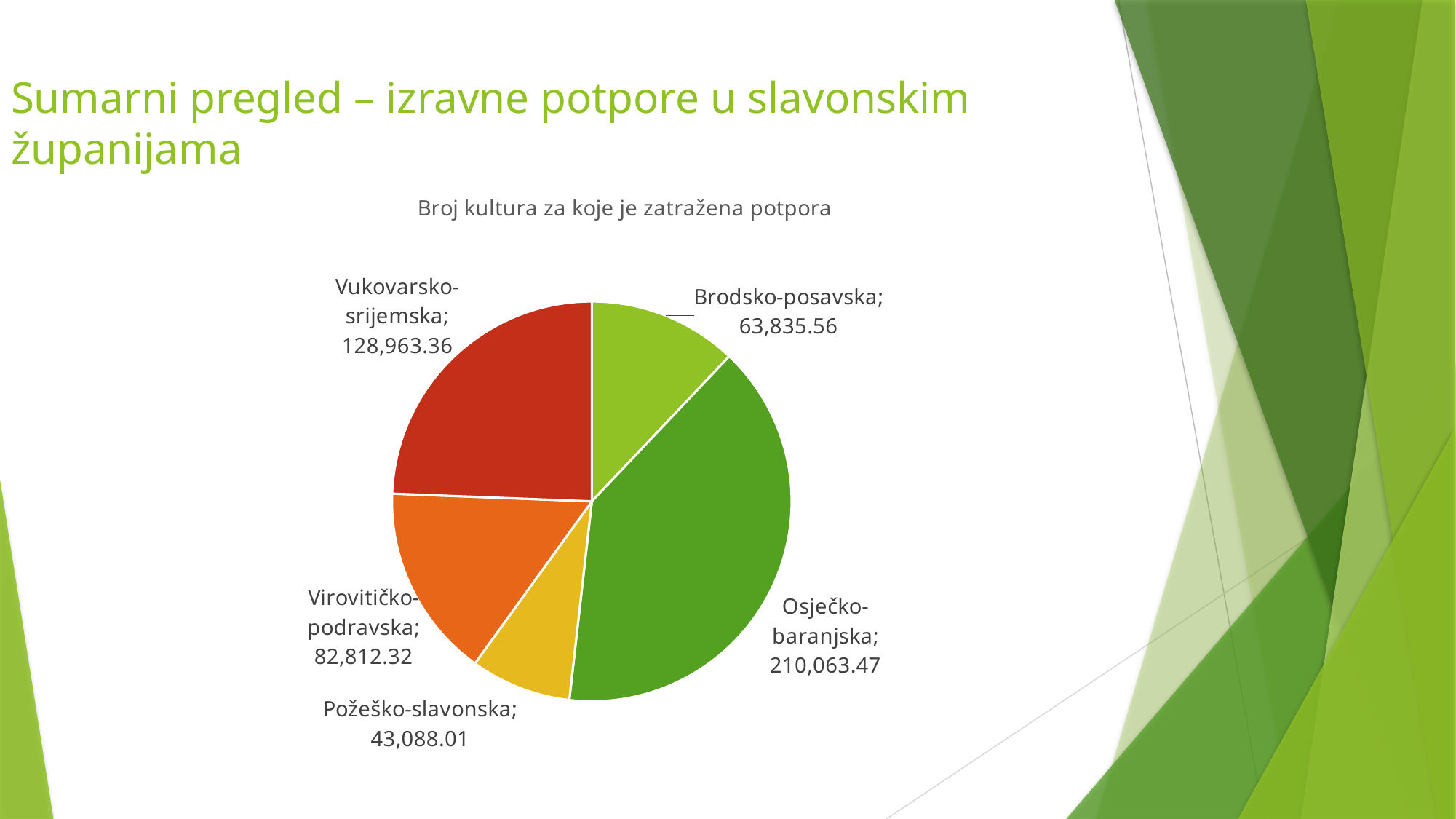
Which county has the smallest slice of the pie? Požeško-slavonska What is the difference between the values for Brodsko-posavska and Požeško-slavonska? 20,747.55 How many slices does the pie chart have? 5 What is the value for Požeško-slavonska? 43,088.01 What is the difference between the values for Osječko-baranjska and Vukovarsko-srijemska? 81,100.11 What is the value for Virovitičko-podravska? 82,812.32 Which county has the largest slice of the pie? Osječko-baranjska What is the value for Osječko-baranjska? 210,063.47 Which is larger, the value for Vukovarsko-srijemska or the value for Virovitičko-podravska? Vukovarsko-srijemska What colour is the Vukovarsko-srijemska slice? red What type of chart is shown on the slide? pie chart What is the title of the chart? Broj kultura za koje je zatražena potpora